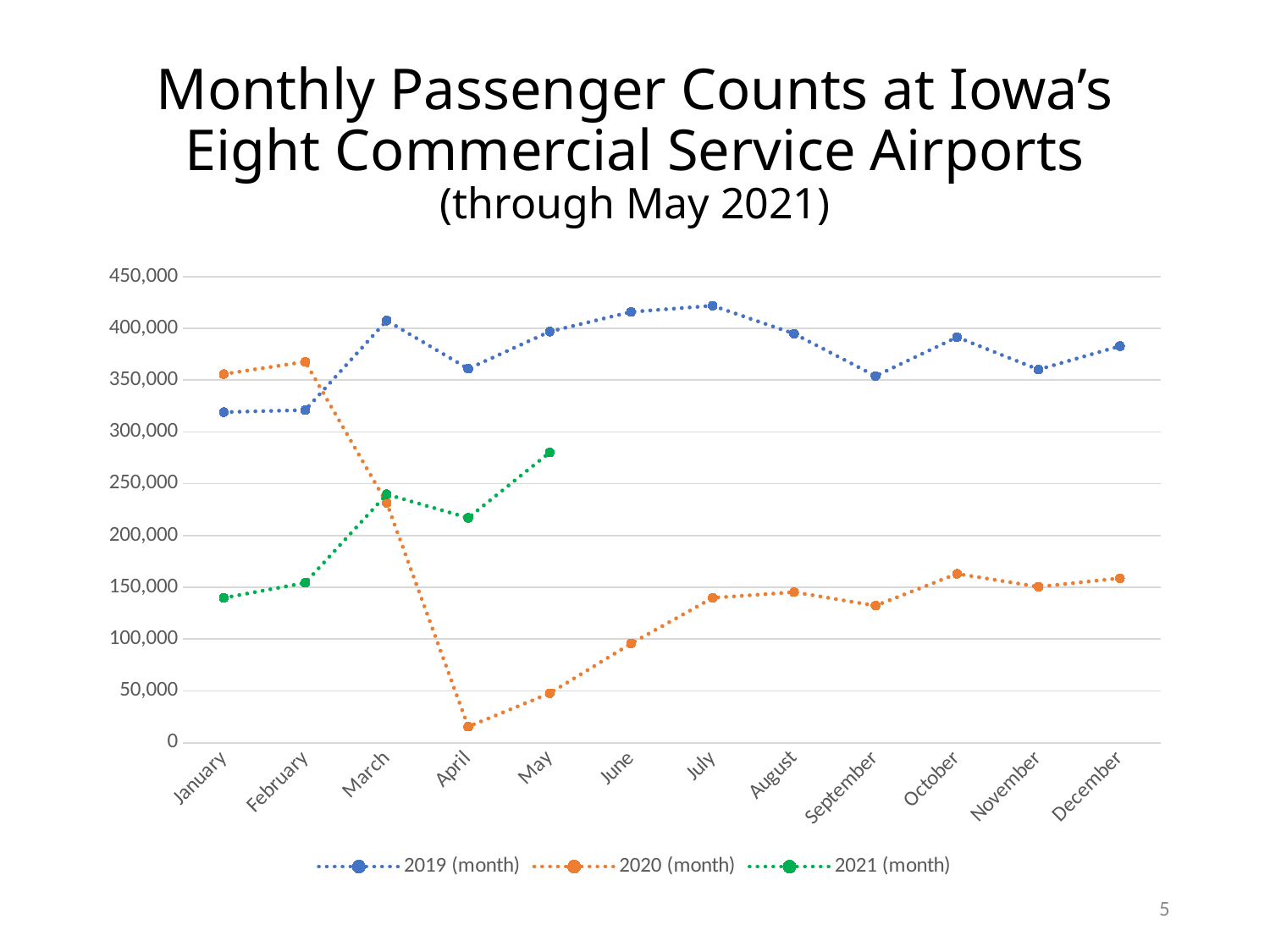
How many series does the legend list? 3 Does the 2020 (month) series rise or fall from February to April? fall In which month does the 2020 (month) series reach its highest value? February What colour is the line for the 2021 (month) series? green Which is larger for January: the 2019 (month) value or the 2020 (month) value? 2020 (month) What kind of chart is shown on the slide? line chart In which month does the 2021 (month) series reach its highest value? May How many months are shown along the x axis? 12 How many data points are plotted for the 2021 (month) series? 5 Is the value for April in the 2020 (month) series greater or less than 50,000? less Is the value for March in the 2019 (month) series greater or less than 400,000? greater In which month does the 2020 (month) series reach its lowest value? April